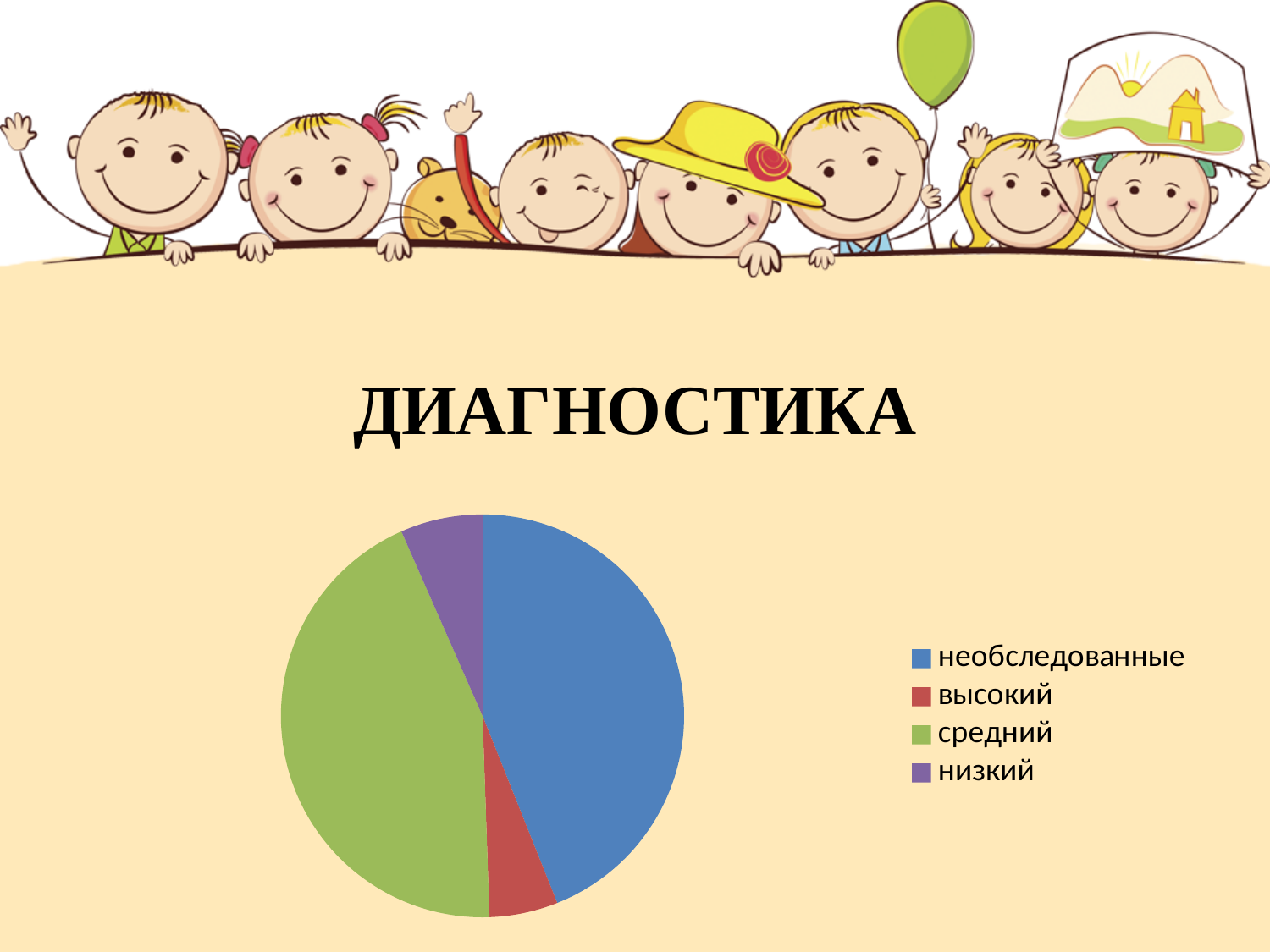
Which slice is larger in the pie chart: "средний" or "низкий"? средний How many categories (slices) does the pie chart have? 4 Which slice is larger in the pie chart: "необследованные" or "высокий"? необследованные What is the title shown above the pie chart? ДИАГНОСТИКА What kind of chart is shown on the slide? pie chart Which colour represents the category "средний" in the pie chart? green